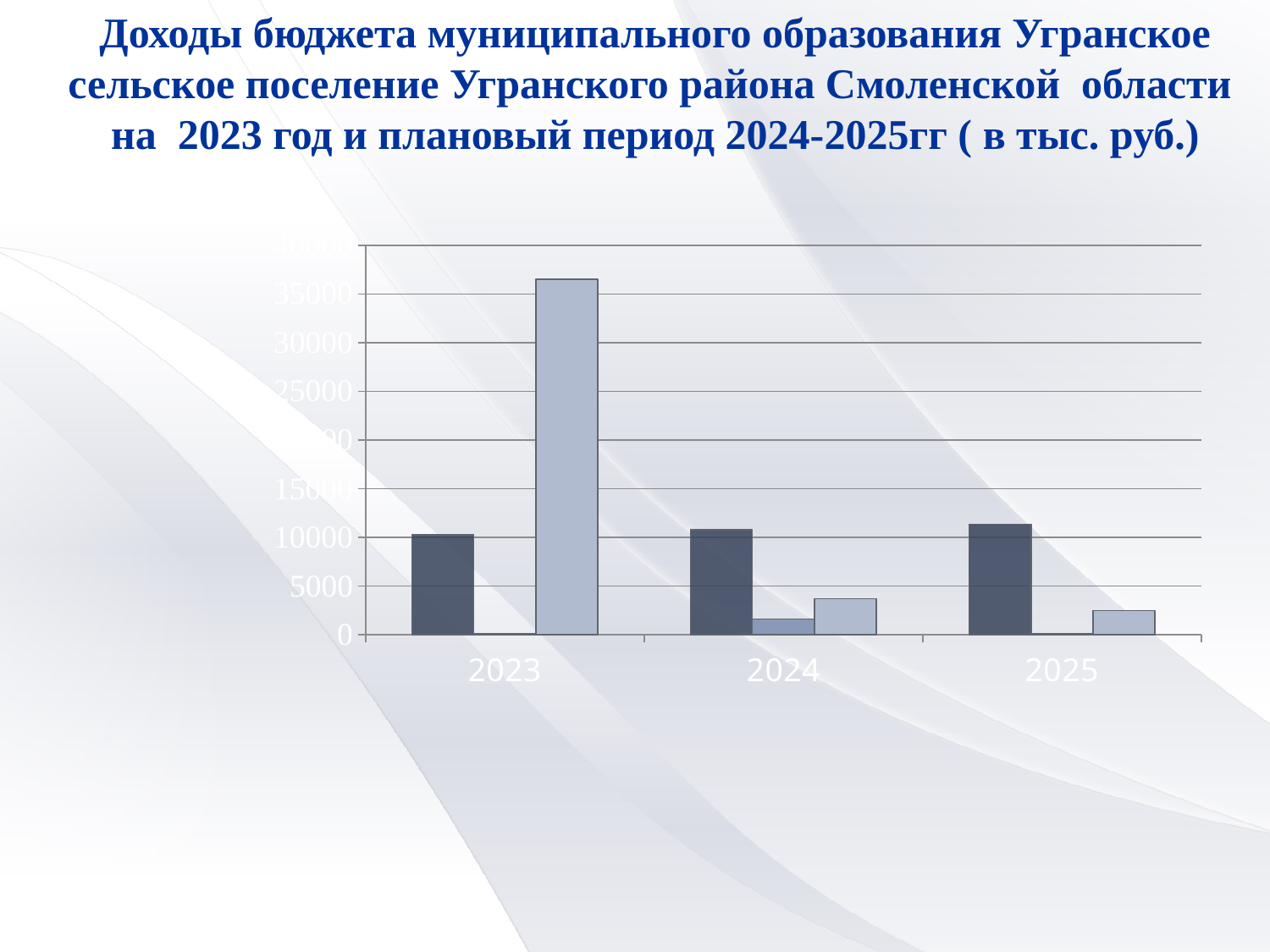
In what units are the values in the chart expressed, according to the slide title? тыс. руб. How many year categories are shown on the x axis of the chart? 3 Is the value of the dark blue bar for 2023 greater or less than 15000? less Is the value of the dark blue bar for 2025 greater or less than 10000? greater Which is larger: the light blue bar for 2024 or the light blue bar for 2025? the light blue bar for 2024 Is the value of the light blue bar for 2024 greater or less than 5000? less Do the values of the light blue bars rise or fall from 2023 to 2025? fall What kind of chart is shown on the slide? bar chart Which year has the tallest bar in the chart? 2023 Which is larger in 2023: the dark blue bar or the light blue bar? the light blue bar